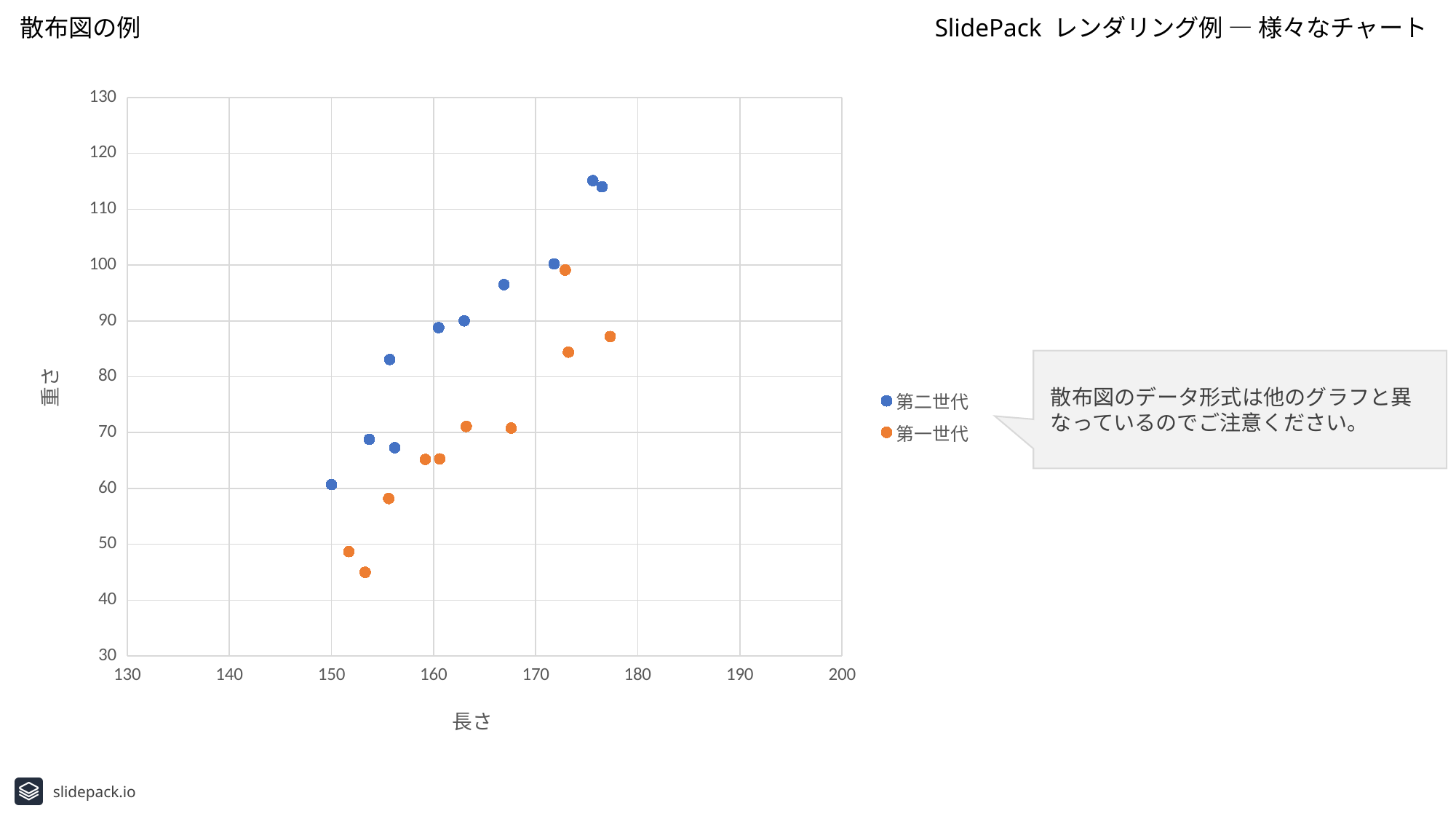
Is the highest 重さ value for 第二世代 greater or less than 110? greater Is the lowest 重さ value for 第一世代 greater or less than 50? less Which series contains the point with the lowest 重さ value? 第一世代 Which series contains the point with the highest 重さ value? 第二世代 What kind of chart is shown on the slide? scatter chart Do the 重さ values generally rise or fall as 長さ increases? rise How many points are plotted for the 第二世代 series? 10 What are the two series named in the legend? 第二世代 and 第一世代 Is the lowest 重さ value for 第二世代 greater or less than 50? greater How many series does the legend list? 2 How many points are plotted for the 第一世代 series? 10 What is the title of the chart? 散布図の例